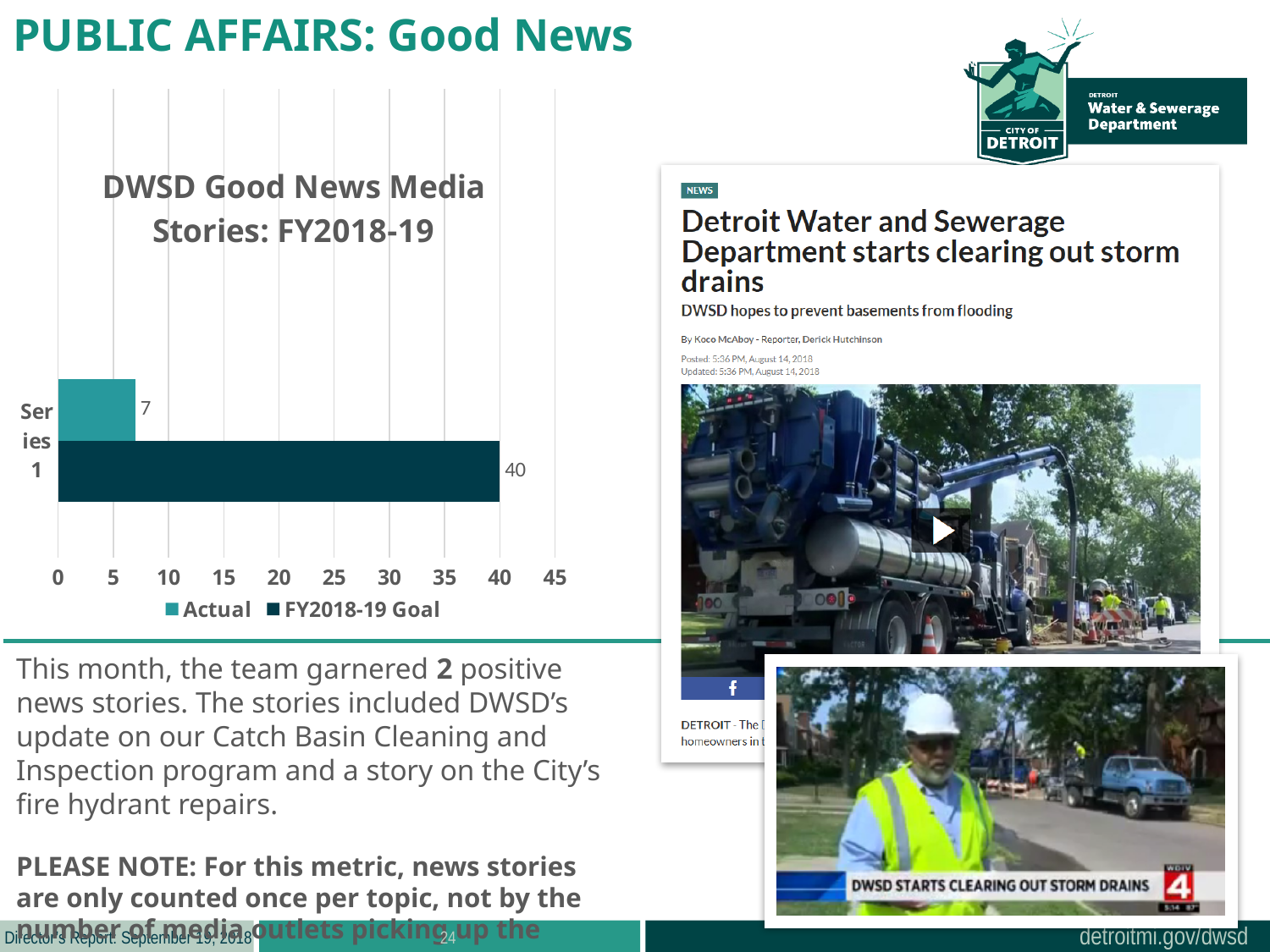
Which series has the larger value, Actual or FY2018-19 Goal? FY2018-19 Goal What is the highest value shown on the x axis of the chart? 45 What is the difference between the FY2018-19 Goal and the Actual value? 33 What is the value of the Actual bar in the chart? 7 Is the Actual value greater or less than 10? less How many bars are plotted in the chart? 2 What is the value of the FY2018-19 Goal bar in the chart? 40 Which series has the highest value in the chart? FY2018-19 Goal What type of chart is shown on the slide? bar chart Which series has the lowest value in the chart? Actual How many series does the chart legend list? 2 What is the title of the chart on the slide? DWSD Good News Media Stories: FY2018-19